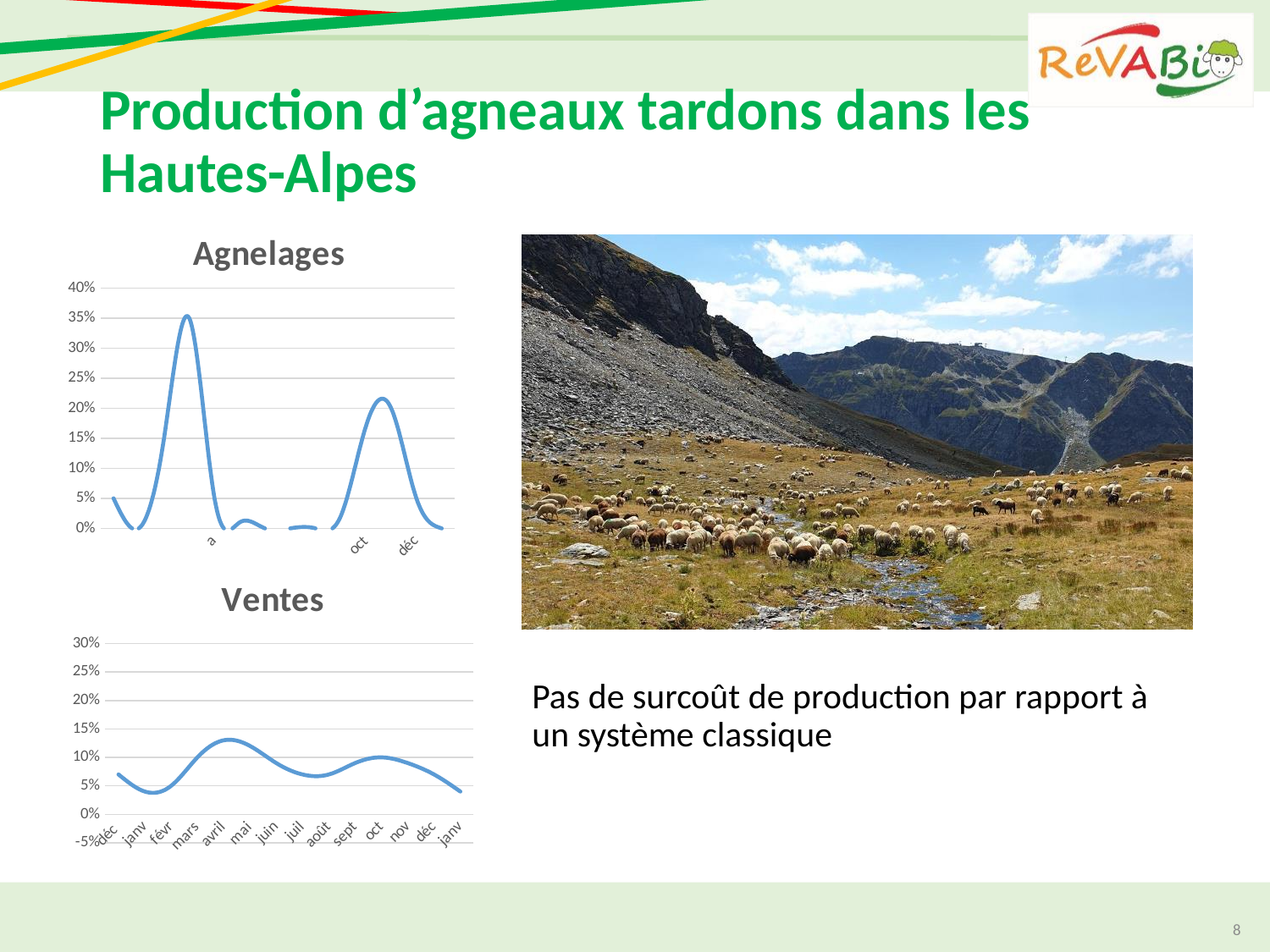
In the 'Ventes' chart, is the value for avril greater or less than 10%? greater In the 'Ventes' chart, which month has the highest value? avril In the 'Agnelages' chart, is the highest peak of the line greater or less than 30%? greater In the 'Ventes' chart, is the value for the first déc greater or less than 5%? greater What is the title of the lower chart on the slide? Ventes In the 'Ventes' chart, do the values rise or fall from avril to juil? fall In the 'Ventes' chart, which is larger, the value for avril or the value for févr? avril What is the title of the upper chart on the slide? Agnelages What kind of chart is the 'Ventes' chart? line chart What kind of chart is the 'Agnelages' chart? line chart